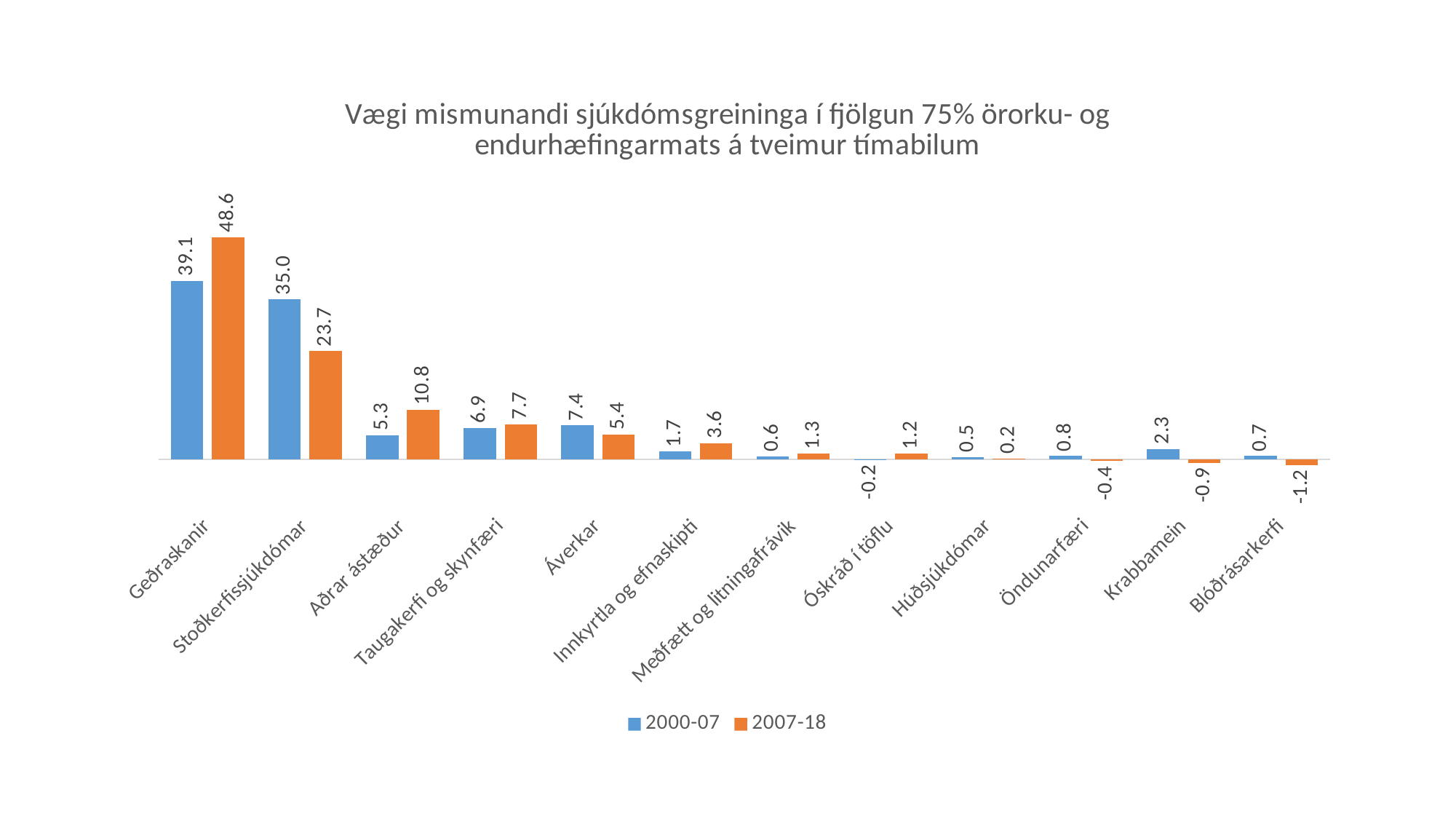
Which category has the highest value in the 2000-07 series? Geðraskanir What is the value for Krabbamein in the 2000-07 series? 2.3 Which category has the lowest value in the 2007-18 series? Blóðrásarkerfi How many categories are shown on the x axis? 12 Which colour represents the 2007-18 series? Orange What is the value for Stoðkerfissjúkdómar in the 2000-07 series? 35.0 Which is larger for Áverkar: the 2000-07 value or the 2007-18 value? 2000-07 What is the value for Geðraskanir in the 2007-18 series? 48.6 What is the value for Blóðrásarkerfi in the 2007-18 series? -1.2 How many series does the legend list? 2 What kind of chart is shown on the slide? Bar chart What is the difference between the 2007-18 and 2000-07 values for Stoðkerfissjúkdómar? 11.3